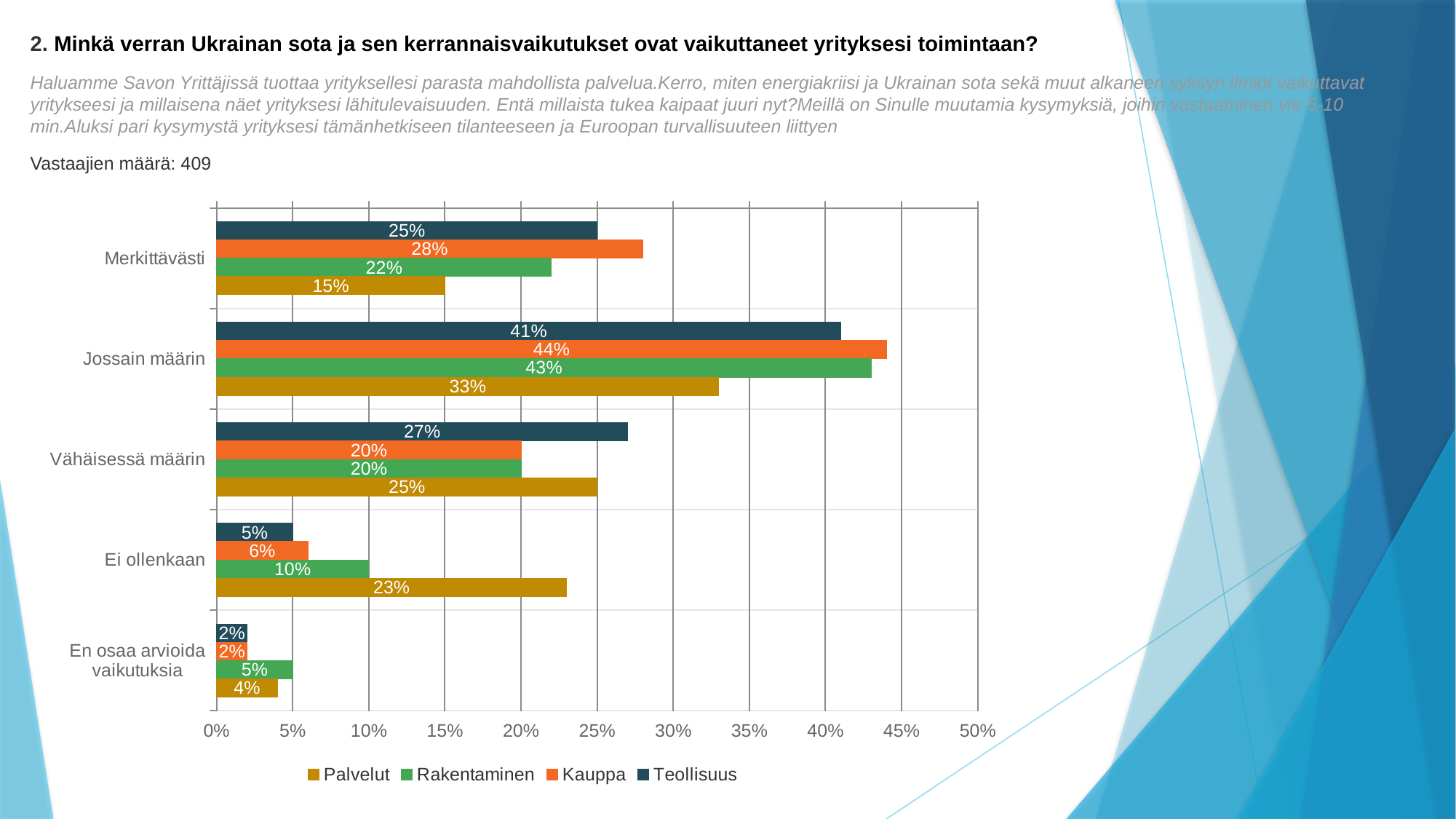
Which category has the highest value for Palvelut? Jossain määrin Which category has the lowest value for Rakentaminen? En osaa arvioida vaikutuksia What kind of chart is shown on the slide? Bar chart How many series does the legend list? 4 What is the value for Teollisuus in the Vähäisessä määrin category? 27% How many categories are shown on the y axis? 5 In the Ei ollenkaan category, which is larger: Rakentaminen or Kauppa? Rakentaminen What is the value for Palvelut in the Ei ollenkaan category? 23% What is the number of respondents (Vastaajien määrä) stated above the chart? 409 Which series is shown in orange in the legend? Kauppa What is the difference between the Kauppa and Palvelut values in the Merkittävästi category? 13% What is the value for Kauppa in the Jossain määrin category? 44%